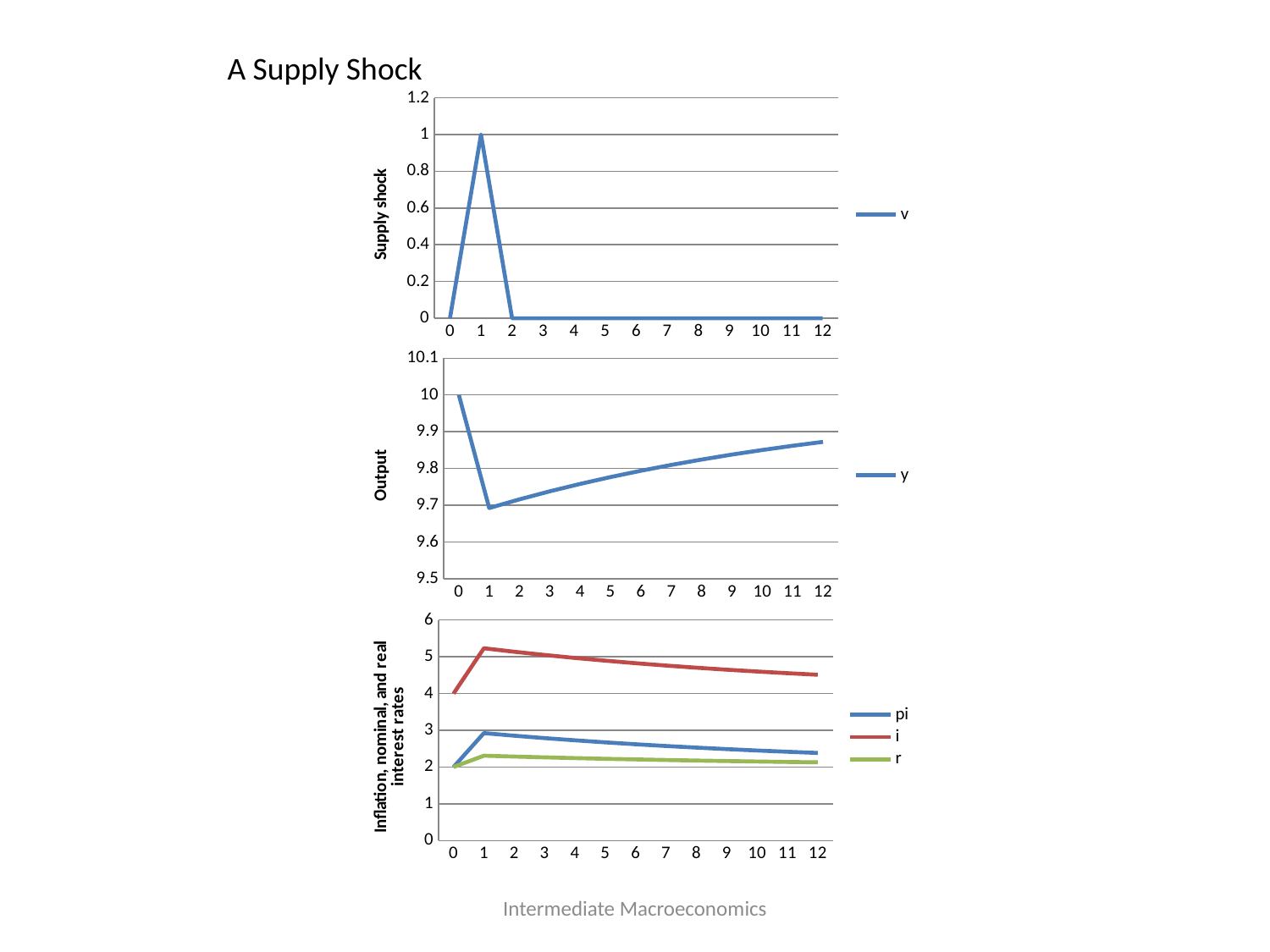
How many series does the legend of the bottom chart list? 3 In the top chart (Supply shock), what is the value of v at period 5? 0 In the top chart (Supply shock), what is the value of v at period 1? 1 How many series does the legend of the middle chart (Output) list? 1 In the middle chart (Output), does y rise or fall from period 1 to period 12? rises What kind of chart is the top chart labelled 'Supply shock'? line chart In the bottom chart, what is the value of i at period 0? 4 In the bottom chart, which series has the highest value at period 1? i In the middle chart (Output), is the value of y at period 1 greater or less than 9.8? less In the bottom chart, is the value of i at period 12 greater or less than 4? greater In the middle chart (Output), what is the value of y at period 0? 10 In the top chart (Supply shock), at which period is v highest? 1